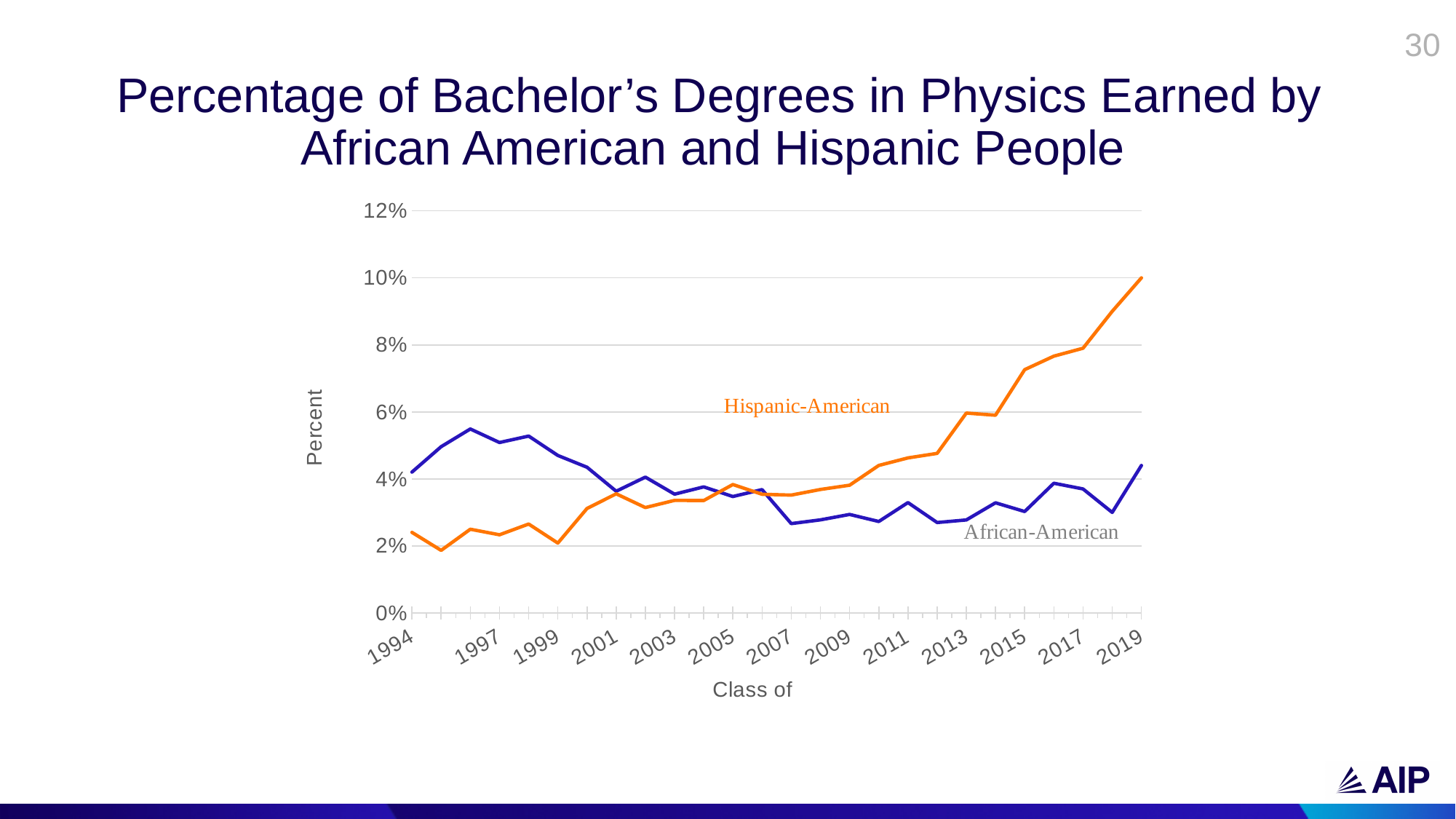
Is the African-American value for the class of 2007 greater or less than 4%? less For the class of 2019, which series has the higher value, Hispanic-American or African-American? Hispanic-American What kind of chart is shown on the slide? line chart Is the Hispanic-American value for the class of 2015 greater or less than 6%? greater Does the Hispanic-American series rise or fall from the class of 2007 to the class of 2019? rise Which two series are plotted on the chart? Hispanic-American and African-American How many data series are plotted on the chart? 2 For the class of 1994, which series has the higher value, Hispanic-American or African-American? African-American Is the Hispanic-American value for the class of 2019 greater or less than 8%? greater What is the label of the x axis? Class of In which class year does the Hispanic-American series reach its highest value? 2019